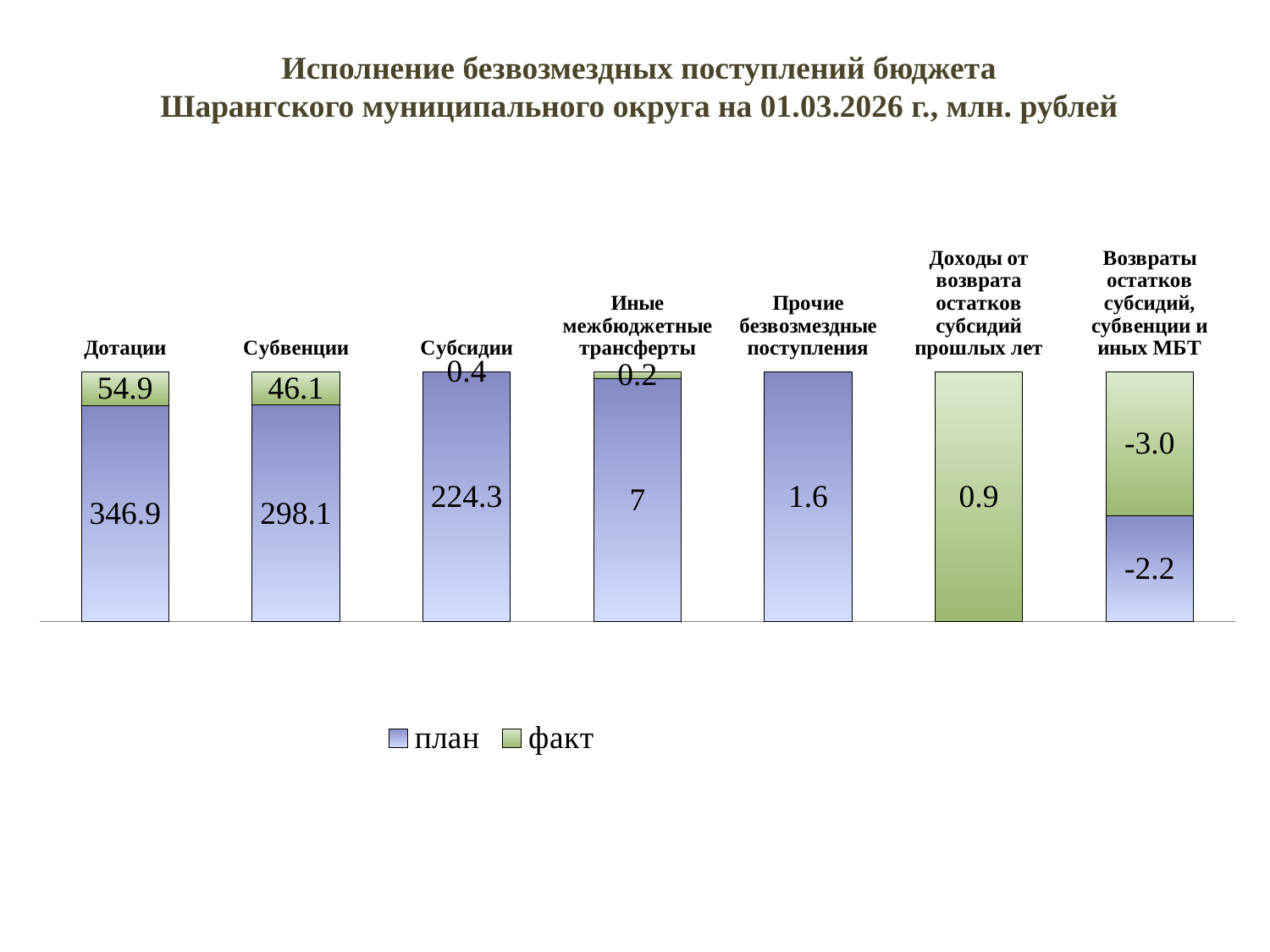
How many categories are shown on the x axis? 7 What is the difference between the план and факт values for Дотации? 292.0 What kind of chart is shown on the slide? Stacked bar chart What is the план value for Субсидии? 224.3 What is the факт value for Субвенции? 46.1 Which series is shown in green according to the legend? факт How many series does the legend list? 2 What is the факт value for Иные межбюджетные трансферты? 0.2 What is the факт value for Возвраты остатков субсидий, субвенции и иных МБТ? -3.0 Which is larger: the план value for Субвенции or the план value for Субсидии? Субвенции Which category has the highest план value? Дотации What is the план value for Дотации? 346.9